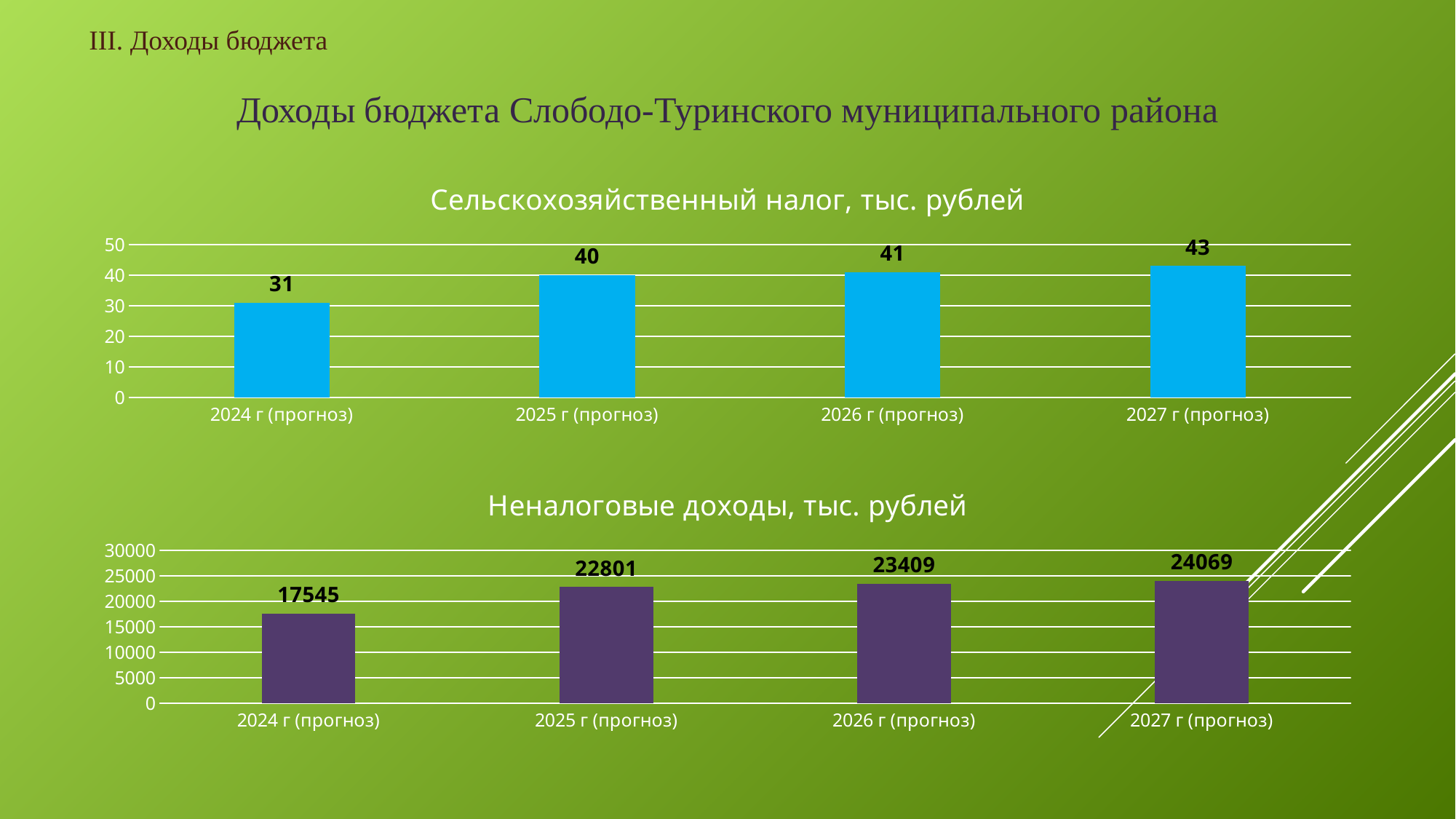
In the chart titled 'Неналоговые доходы, тыс. рублей', what is the value for 2024 г (прогноз)? 17545 In the chart titled 'Неналоговые доходы, тыс. рублей', which year has the highest value? 2027 г (прогноз) In the chart titled 'Сельскохозяйственный налог, тыс. рублей', what is the difference between the values for 2027 г (прогноз) and 2024 г (прогноз)? 12 In the chart titled 'Сельскохозяйственный налог, тыс. рублей', do the values rise or fall from 2024 to 2027? rise In the chart titled 'Сельскохозяйственный налог, тыс. рублей', what is the value for 2024 г (прогноз)? 31 In the chart titled 'Сельскохозяйственный налог, тыс. рублей', which year has the highest value? 2027 г (прогноз) In the chart titled 'Сельскохозяйственный налог, тыс. рублей', which year has the lowest value? 2024 г (прогноз) In the chart titled 'Неналоговые доходы, тыс. рублей', what is the value for 2026 г (прогноз)? 23409 What type of chart is the chart titled 'Неналоговые доходы, тыс. рублей'? bar chart In the chart titled 'Неналоговые доходы, тыс. рублей', is the value for 2025 г (прогноз) larger or smaller than the value for 2026 г (прогноз)? smaller In the chart titled 'Неналоговые доходы, тыс. рублей', what is the difference between the values for 2025 г (прогноз) and 2024 г (прогноз)? 5256 In the chart titled 'Сельскохозяйственный налог, тыс. рублей', how many bars are plotted? 4